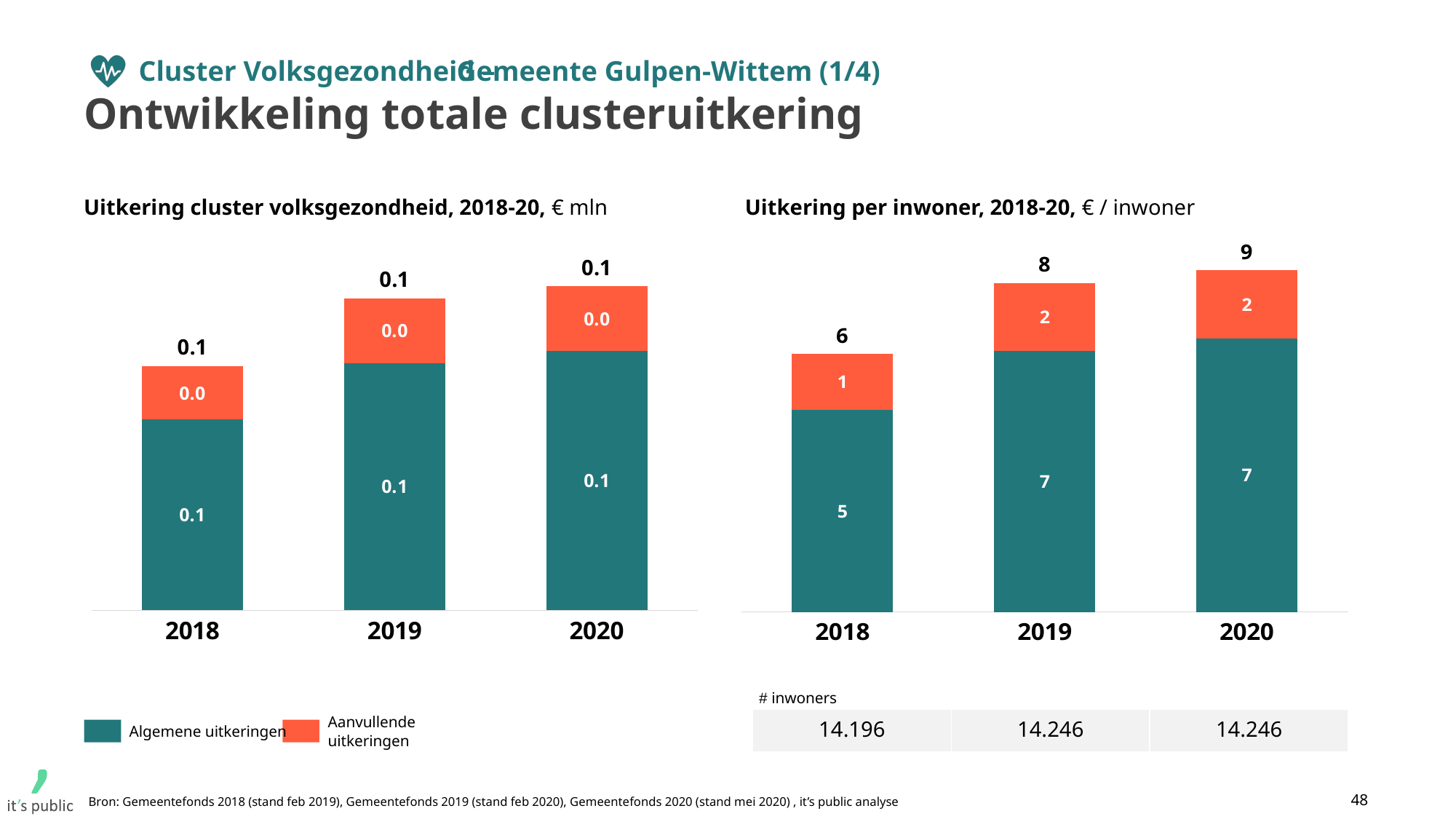
In the 'Uitkering per inwoner' chart, what is the value of the Algemene uitkeringen segment for 2018? 5 How many years are shown on the x axis of the 'Uitkering per inwoner' chart? 3 In the 'Uitkering per inwoner' chart, what is the total value labelled above the bar for 2020? 9 In the 'Uitkering per inwoner' chart, which year has the highest total uitkering per inwoner? 2020 In the 'Uitkering per inwoner' chart, what is the value of the Aanvullende uitkeringen segment for 2019? 2 In the 'Uitkering cluster volksgezondheid' chart, what is the value of the Algemene uitkeringen segment for 2020? 0.1 What type of chart is the 'Uitkering per inwoner, 2018-20' chart? Stacked bar chart In the 'Uitkering per inwoner' chart, which year has the lowest total uitkering per inwoner? 2018 In the 'Uitkering cluster volksgezondheid' chart, what is the total value labelled above the bar for 2019? 0.1 In the 'Uitkering per inwoner' chart, what is the difference between the total for 2020 and the total for 2018? 3 In the 'Uitkering per inwoner' chart, is the Algemene uitkeringen segment larger in 2019 or in 2018? 2019 How many series does the legend list for the charts on this slide? 2